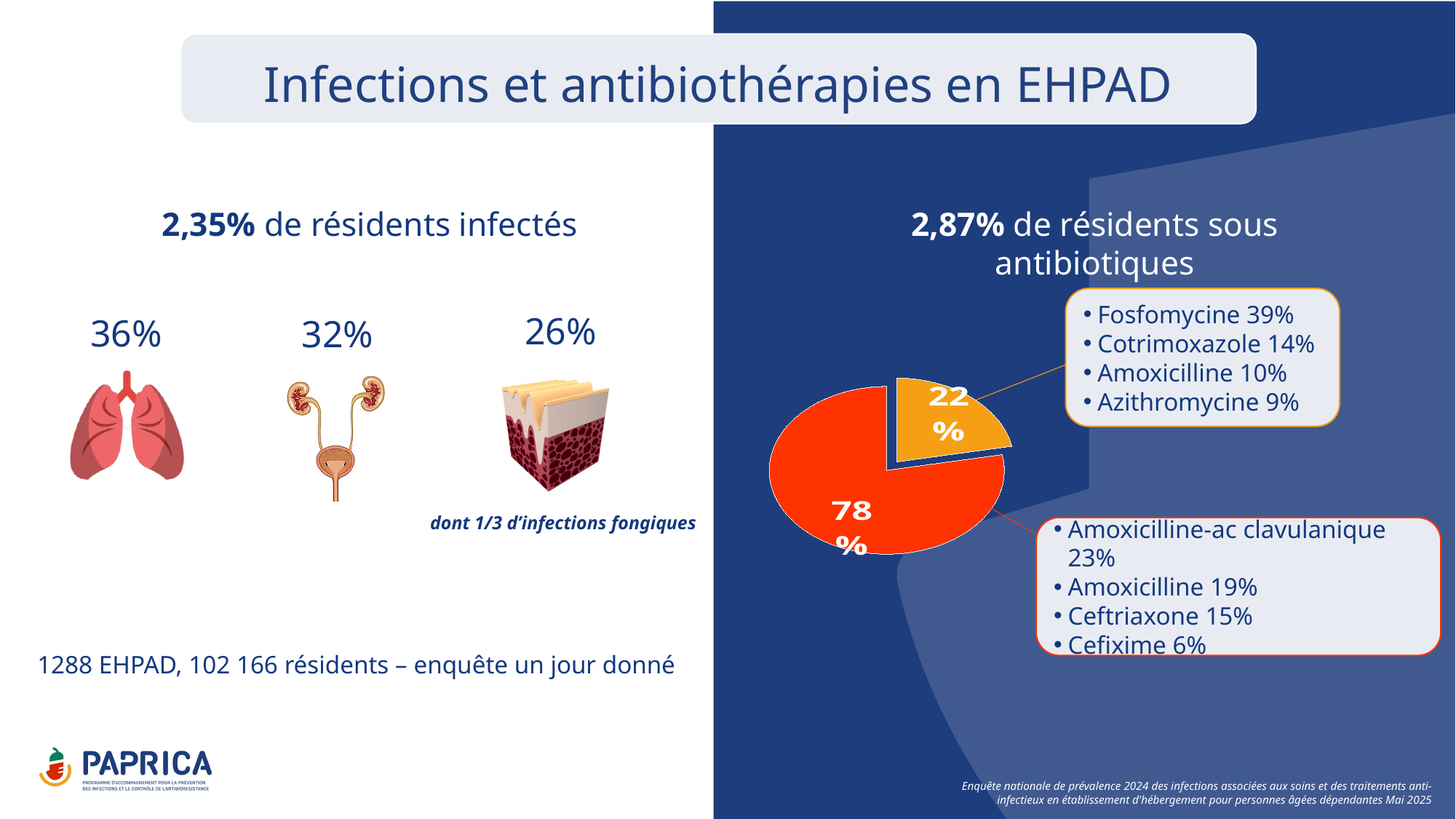
In the callout box linked to the red slice of the pie chart, what percentage is given for Ceftriaxone? 15% Which slice of the pie chart is larger, the red one or the orange one? the red one What is the value of the largest slice of the pie chart? 78% What is the difference between the two slices of the pie chart? 56% How many slices does the pie chart have? 2 Is the value of the red slice of the pie chart greater or less than 50%? greater What colour is the 78% slice of the pie chart? red What percentage is shown on the red slice of the pie chart? 78% What kind of chart is shown on the right side of the slide? pie chart In the callout box linked to the orange slice of the pie chart, what percentage is given for Fosfomycine? 39% What is the value of the smallest slice of the pie chart? 22% What percentage is shown on the orange slice of the pie chart? 22%